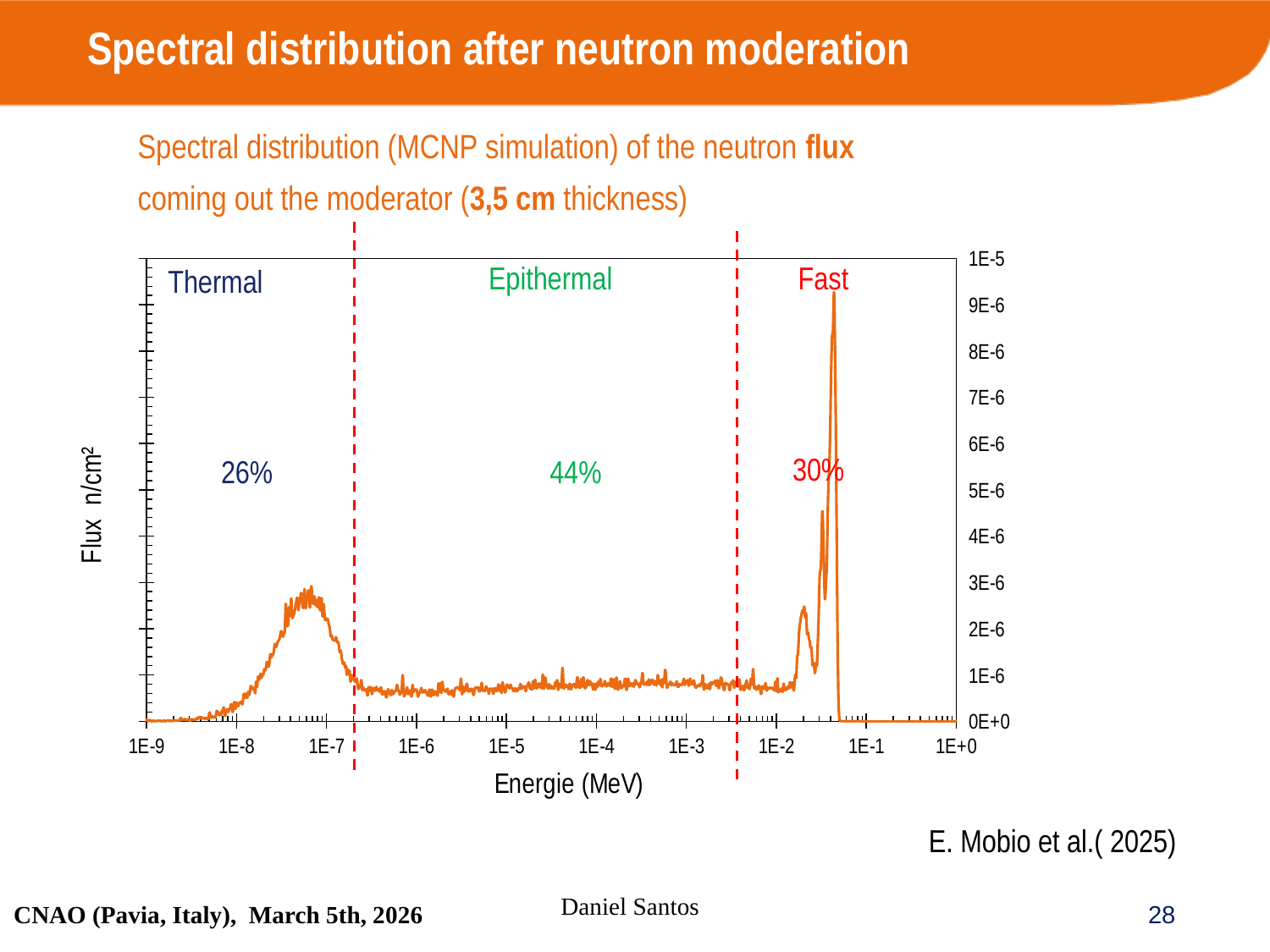
What is the label of the x axis? Energie (MeV) What is the difference between the Epithermal and Thermal percentages? 18% How many energy regions are marked on the chart? 3 What percentage of the neutron flux is in the Epithermal region? 44% Is the peak of the flux in the Thermal region greater or less than 4E-6? less What percentage of the neutron flux is in the Thermal region? 26% Which region has a larger share of the flux, Fast or Thermal? Fast What kind of chart is shown on the slide? line chart Is the highest peak of the flux in the Fast region greater or less than 8E-6? greater What percentage of the neutron flux is in the Fast region? 30% Which energy region has the largest share of the neutron flux? Epithermal Which energy region has the smallest share of the neutron flux? Thermal